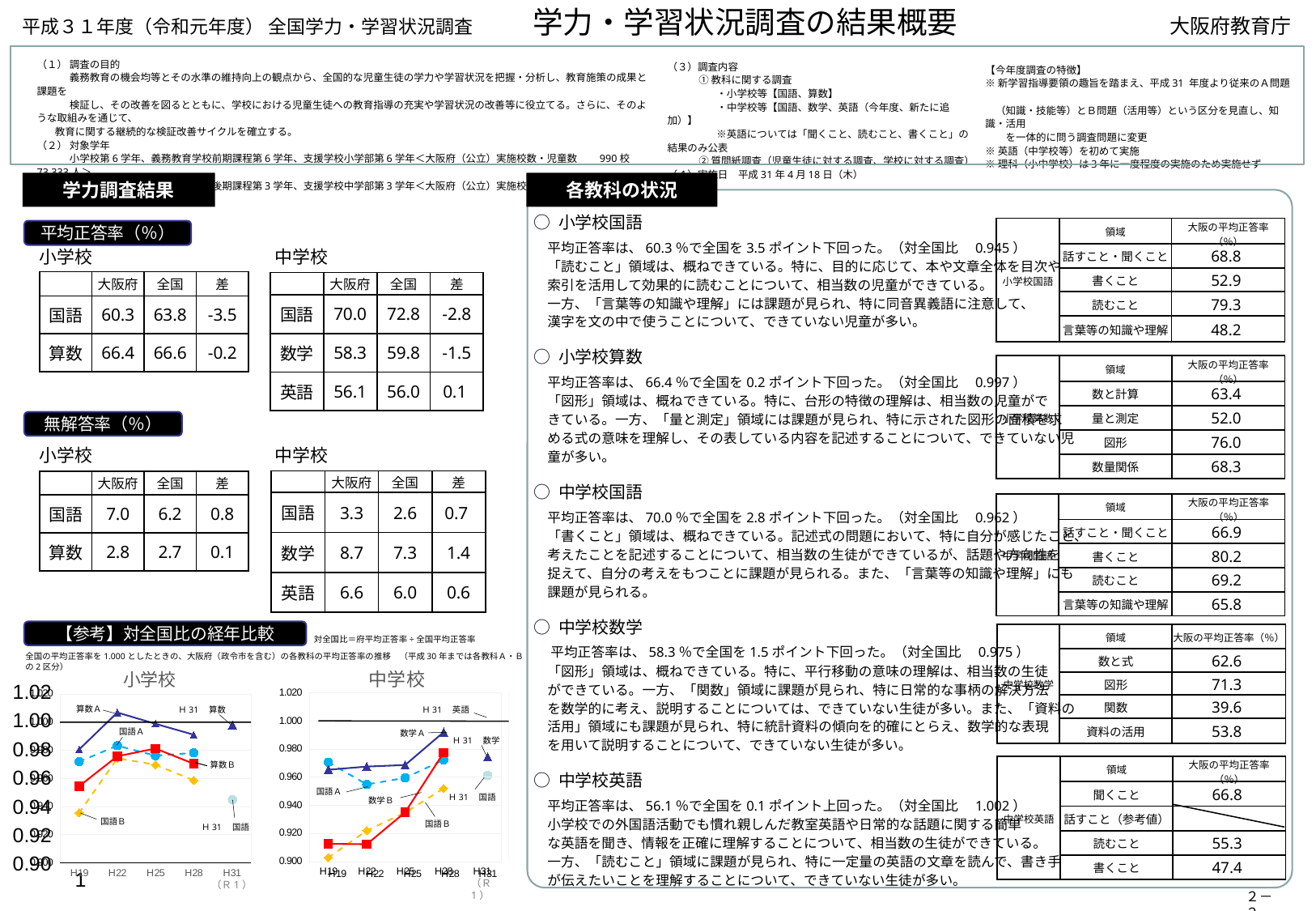
How many year labels are shown on the x axis of the 中学校 chart? 5 In the 小学校 chart, does the 算数B line rise or fall from H22 to H28? fall What is the title of the line chart on the right of the two at the bottom of the slide? 中学校 In the 小学校 chart, is the value for 算数A at H22 greater or less than 1.000? greater In the 中学校 chart, is the value for 数学B at H19 greater or less than 0.920? less In the 小学校 chart, which series has the highest value at H22? 算数A In the 中学校 chart, does the 数学B line rise or fall from H19 to H28? rise In the 小学校 chart, is the value for 算数B at H19 greater or less than 0.960? less What kind of chart is the 小学校 chart at the bottom left of the slide? line chart In the 中学校 chart at H19, which is higher, 国語A or 数学B? 国語A